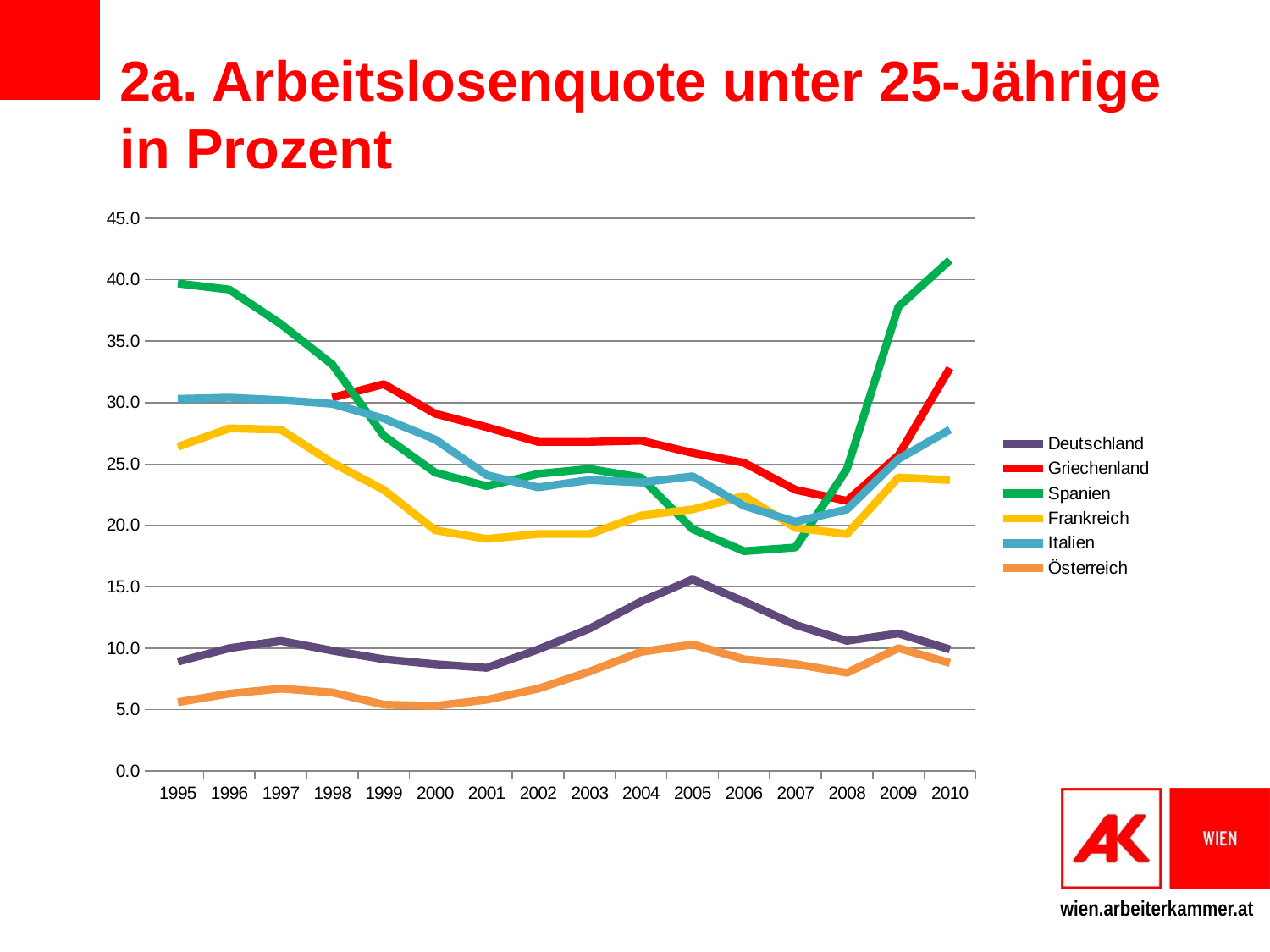
Does the value for Spanien rise or fall from 1995 to 2000? fall Which colour is used for the Spanien line in the legend? green What kind of chart is shown on the slide? line chart How many series does the legend list? 6 Is the value for Spanien in 2010 greater or less than 40? greater Is the value for Frankreich in 2001 greater or less than 20? less How many years are shown along the x axis? 16 Which country has the lowest youth unemployment rate in 1995? Österreich Is the value for Griechenland in 1999 greater or less than 30? greater Which country has the highest youth unemployment rate in 2010? Spanien In 2005, which is larger: the value for Deutschland or the value for Österreich? Deutschland In 2007, which is larger: the value for Spanien or the value for Italien? Italien